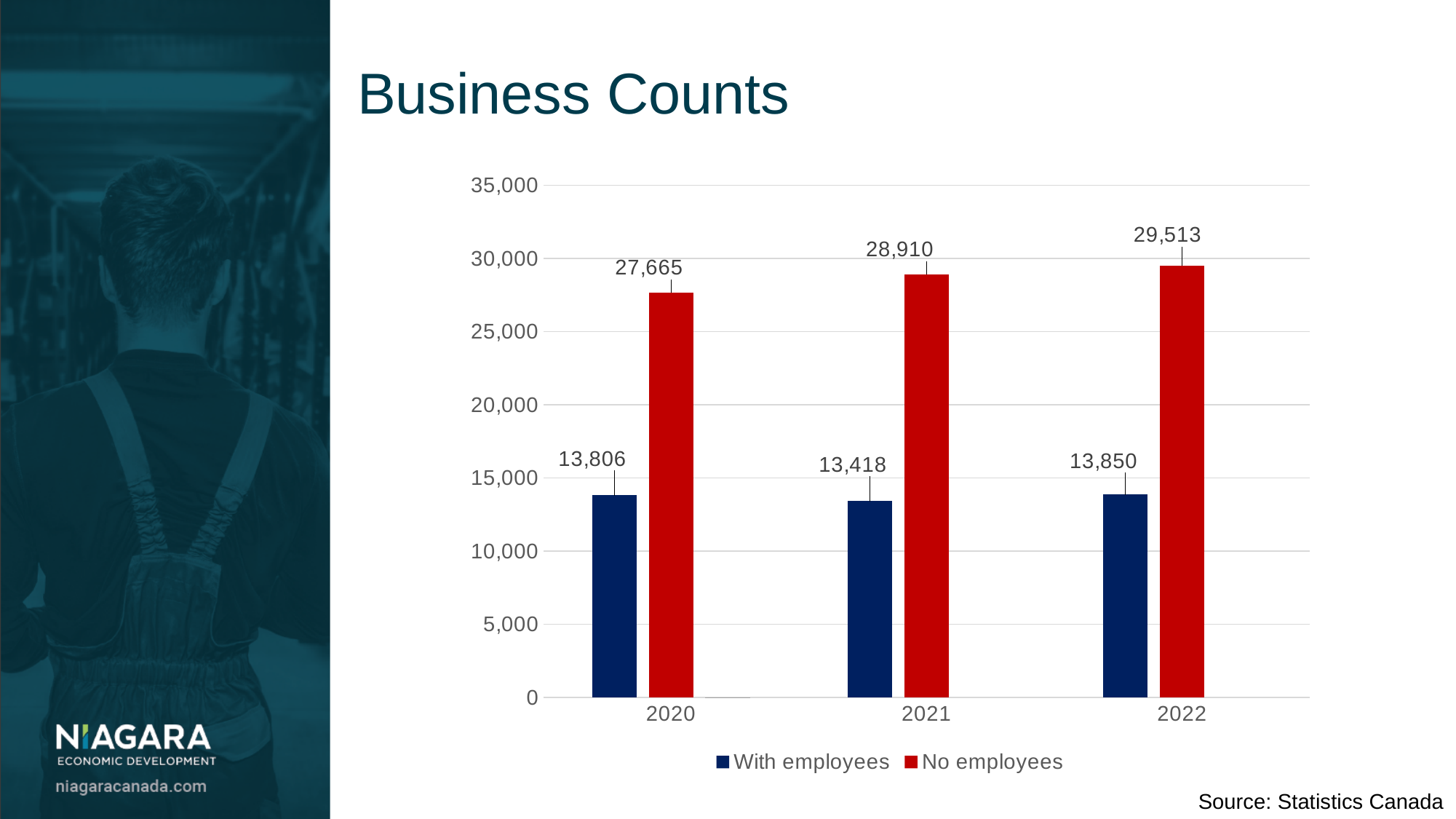
Which year has the lowest value for "With employees"? 2021 Is the value for "No employees" in 2020 greater or less than 25,000? greater What kind of chart is shown on the slide? Bar chart What is the difference between "No employees" and "With employees" in 2020? 13,859 What is the value for "No employees" in 2021? 28,910 Which year has the highest value for "No employees"? 2022 How many years are shown on the x axis? 3 What is the value for "No employees" in 2022? 29,513 Does the "No employees" series rise or fall from 2020 to 2022? Rise How many series does the legend list? 2 Which is larger in 2022: "With employees" or "No employees"? No employees What is the value for "With employees" in 2020? 13,806